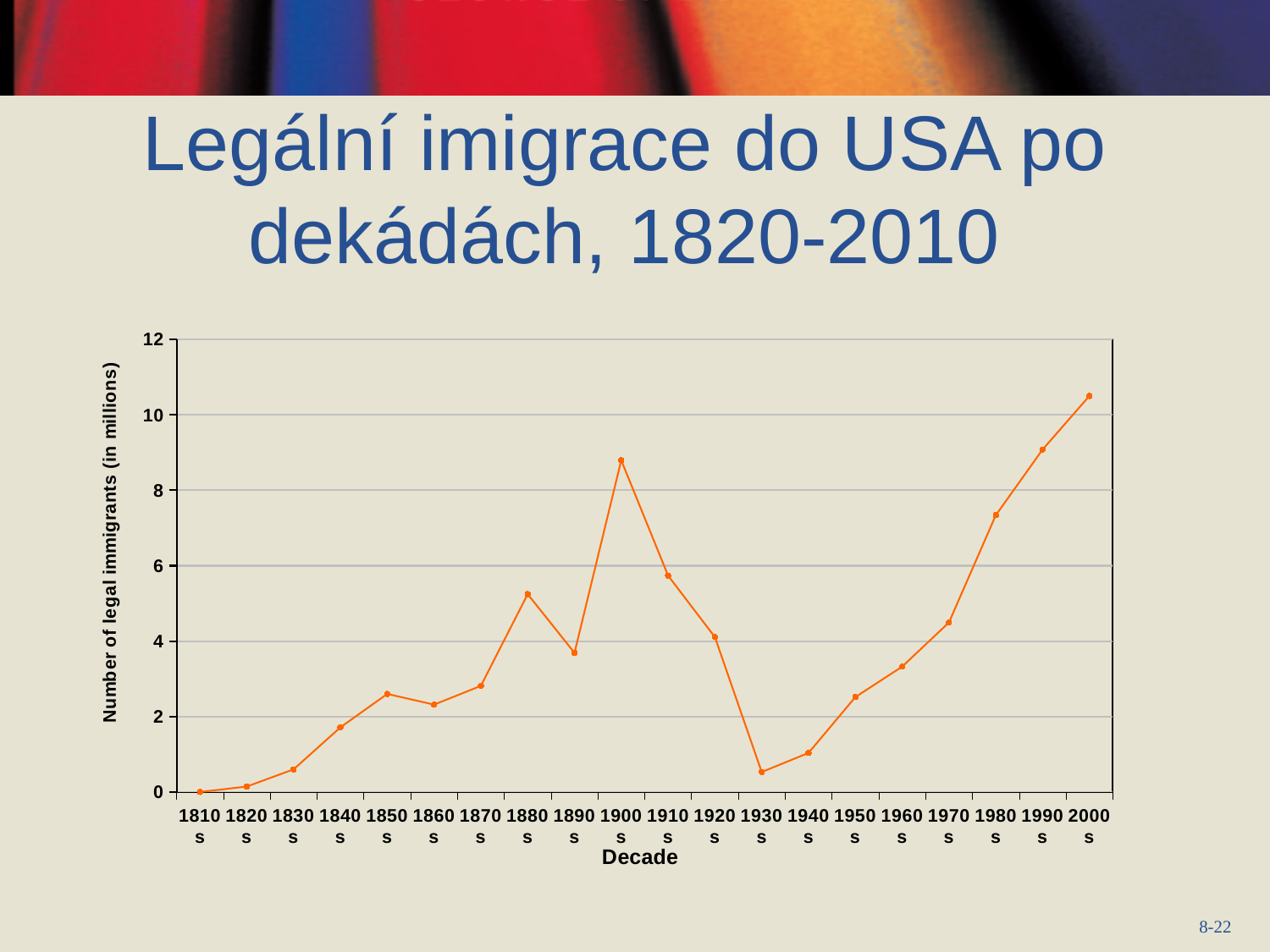
Which decade has the lowest number of legal immigrants? 1810s Which decade has the highest number of legal immigrants? 2000s How many decades are plotted along the x axis? 20 Is the value for the 1960s greater or less than 4? less Do the values rise or fall from the 1930s to the 2000s? rise What is the title of the y axis? Number of legal immigrants (in millions) What kind of chart is shown on the slide? line chart Which decade has a larger value, the 1900s or the 1880s? 1900s Is the value for the 1880s greater or less than 4? greater Is the value for the 1930s greater or less than 2? less